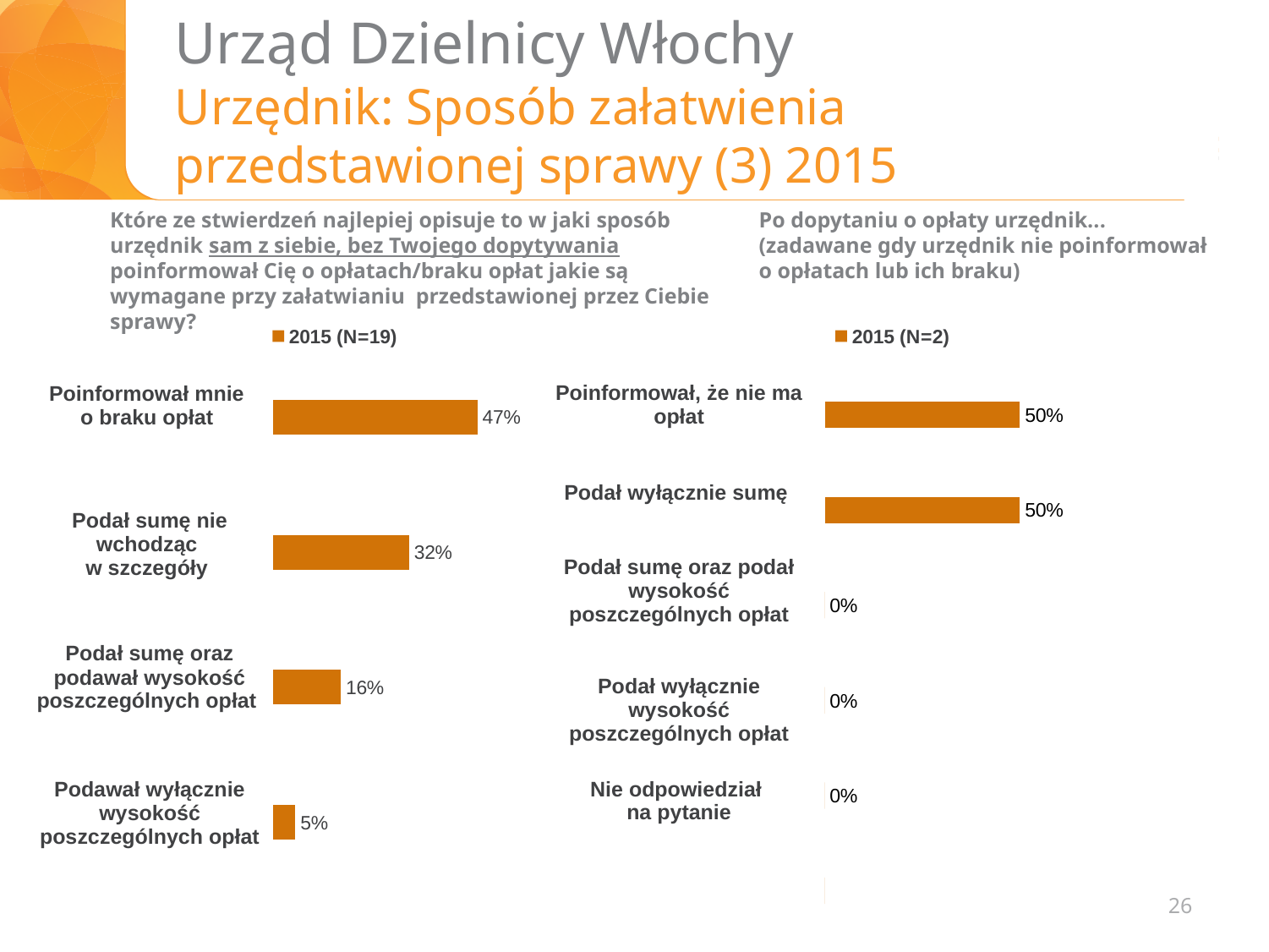
What is the legend entry of the right chart? 2015 (N=2) In the left chart (2015, N=19), which category has the highest value? Poinformował mnie o braku opłat In the left chart (2015, N=19), what is the value for 'Poinformował mnie o braku opłat'? 47% In the right chart (2015, N=2), what is the value for 'Podał wyłącznie sumę'? 50% In the left chart (2015, N=19), what is the value for 'Podawał wyłącznie wysokość poszczególnych opłat'? 5% In the left chart (2015, N=19), what is the value for 'Podał sumę nie wchodząc w szczegóły'? 32% In the left chart (2015, N=19), which category has the lowest value? Podawał wyłącznie wysokość poszczególnych opłat In the right chart (2015, N=2), how many categories are shown? 5 What type of chart is the left chart (2015, N=19)? Bar chart In the left chart (2015, N=19), what is the difference between 'Poinformował mnie o braku opłat' and 'Podał sumę oraz podawał wysokość poszczególnych opłat'? 31% In the left chart (2015, N=19), how many categories are shown? 4 In the right chart (2015, N=2), what is the value for 'Nie odpowiedział na pytanie'? 0%